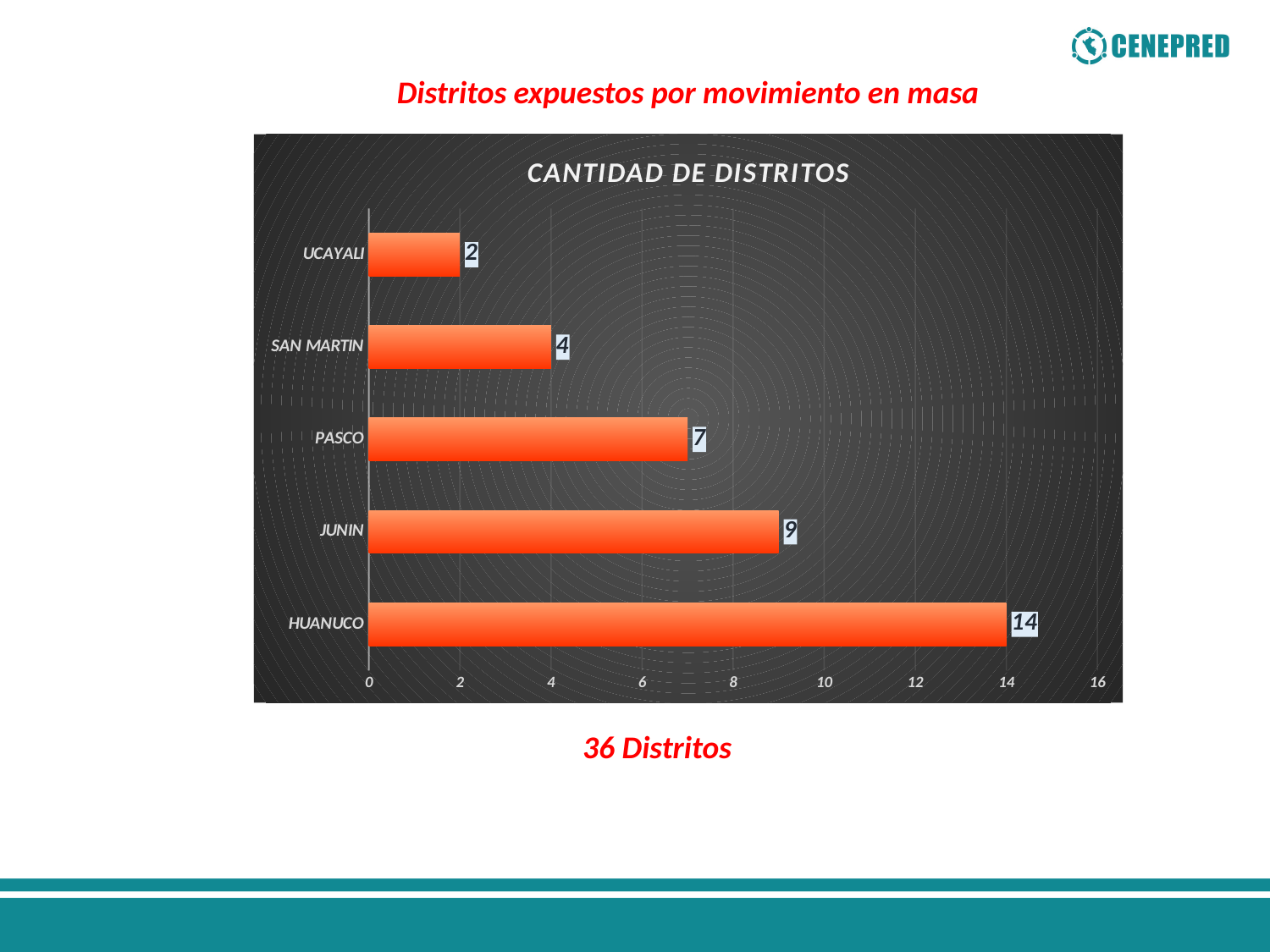
What is the total of all the values shown in the chart? 36 Is the value for JUNIN greater or less than 8? greater What is the title of the chart? CANTIDAD DE DISTRITOS What is the difference between the values for HUANUCO and JUNIN? 5 Which is larger, the value for SAN MARTIN or the value for PASCO? PASCO What is the value for UCAYALI? 2 Which category has the lowest value? UCAYALI What is the value for HUANUCO? 14 How many categories are shown in the chart? 5 Which category has the highest value? HUANUCO What is the value for PASCO? 7 What kind of chart is shown? bar chart